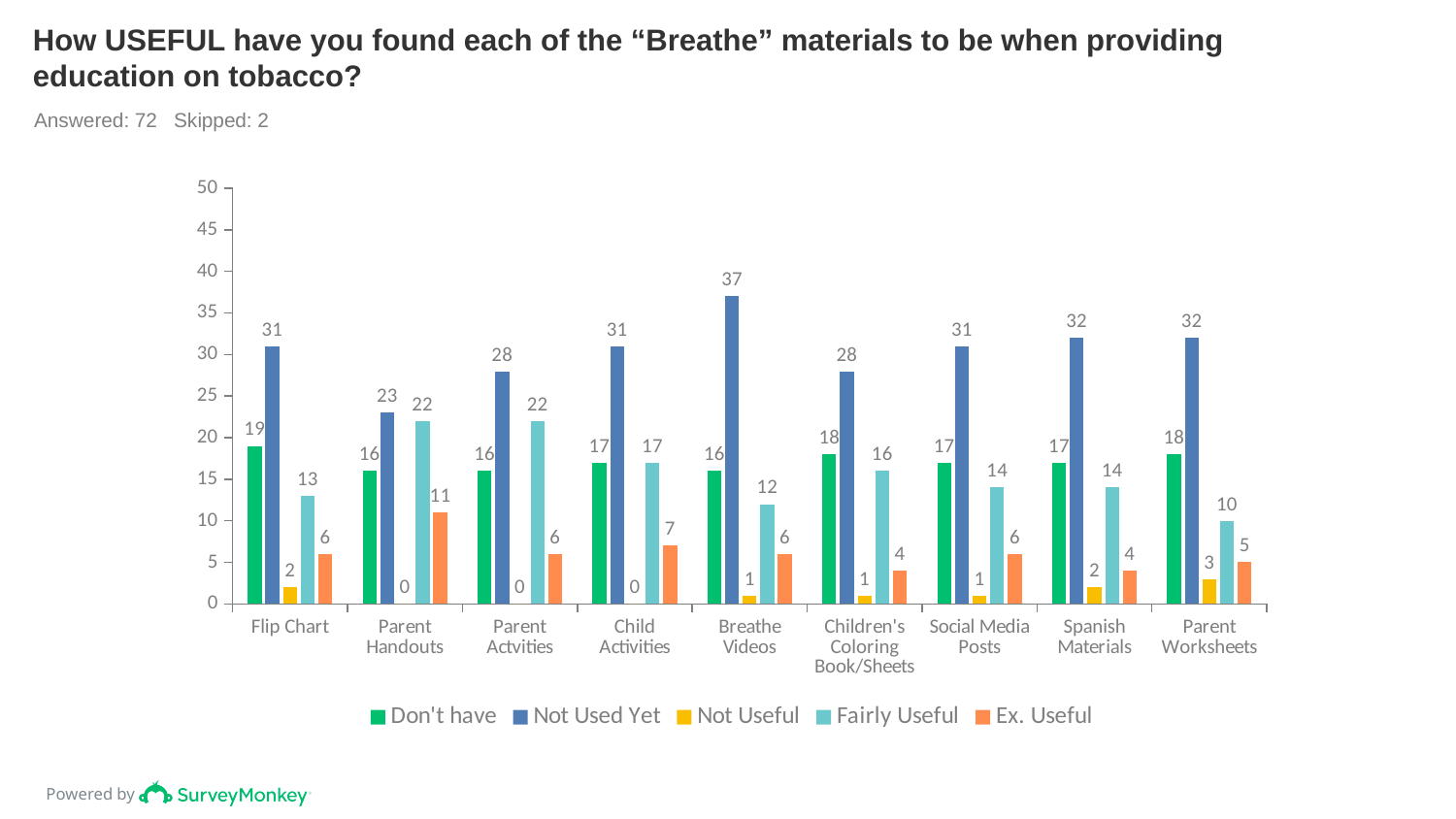
Which material has the lowest "Fairly Useful" value? Parent Worksheets What is the "Fairly Useful" value for Parent Worksheets? 10 What is the total of all five values for Spanish Materials? 69 What is the difference between the "Not Used Yet" and "Don't have" values for Flip Chart? 12 How many materials (categories) are shown on the x axis? 9 Which is larger for Parent Handouts: the "Not Used Yet" value or the "Fairly Useful" value? Not Used Yet What is the "Not Used Yet" value for Breathe Videos? 37 What kind of chart is shown on the slide? Bar chart Which material has the highest "Not Used Yet" value? Breathe Videos What is the "Ex. Useful" value for Parent Handouts? 11 How many respondents answered the question, according to the slide? 72 How many series does the legend list? 5